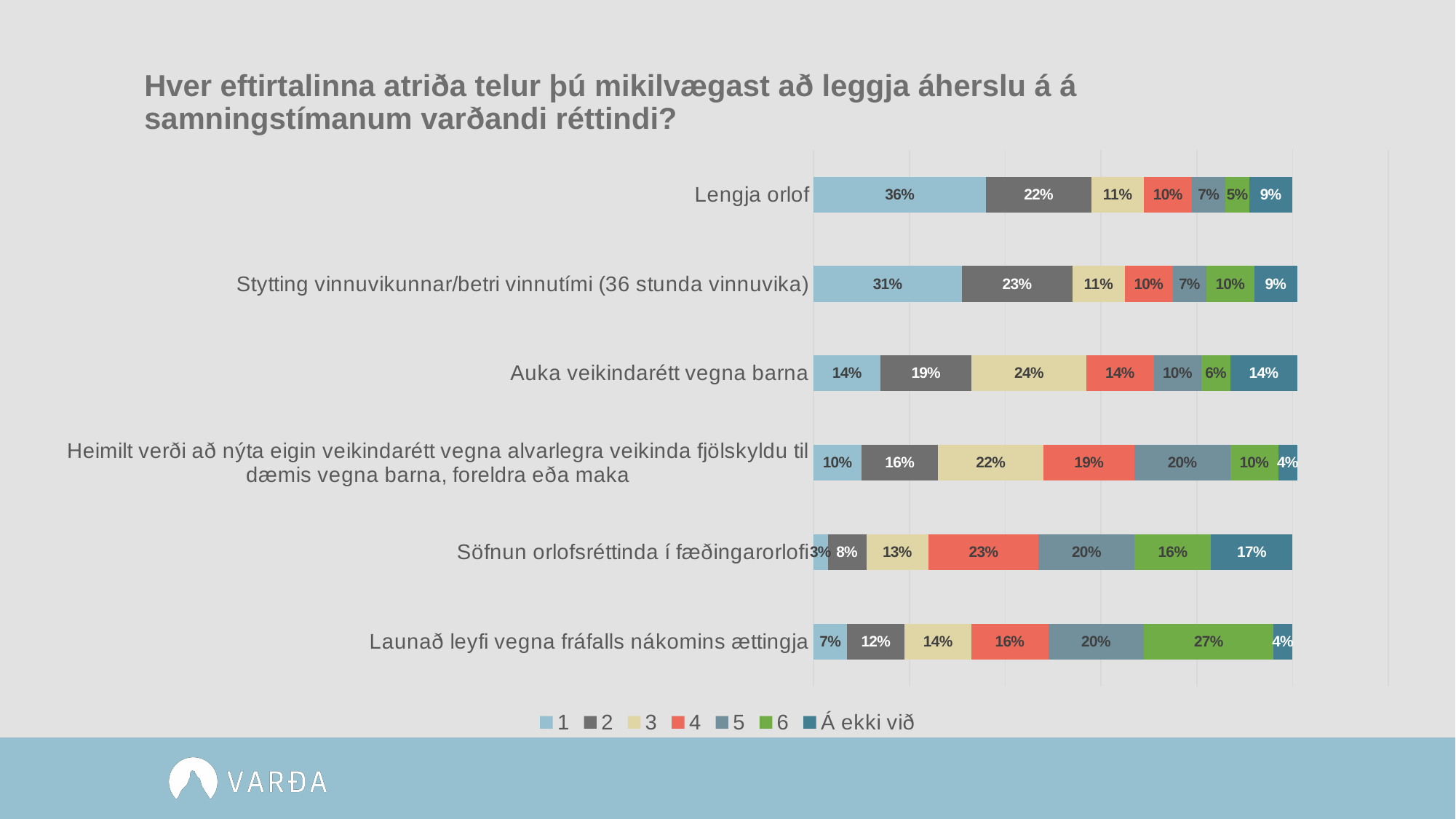
What is the value of series 6 for "Launað leyfi vegna fráfalls nákomins ættingja"? 27% How many series does the legend list? 7 What kind of chart is shown on the slide? Stacked bar chart How many categories are shown in the chart? 6 Which has the larger series 4 value: "Söfnun orlofsréttinda í fæðingarorlofi" or "Launað leyfi vegna fráfalls nákomins ættingja"? Söfnun orlofsréttinda í fæðingarorlofi What is the value of series 2 for "Stytting vinnuvikunnar/betri vinnutími (36 stunda vinnuvika)"? 23% What is the "Á ekki við" value for "Söfnun orlofsréttinda í fæðingarorlofi"? 17% What percentage of respondents rated "Lengja orlof" as 1? 36% Which category has the lowest value for series 1? Söfnun orlofsréttinda í fæðingarorlofi How much larger is the series 1 value for "Lengja orlof" than for "Stytting vinnuvikunnar/betri vinnutími (36 stunda vinnuvika)"? 5% Which category has the highest value for series 1? Lengja orlof What is the value of series 3 for "Auka veikindarétt vegna barna"? 24%